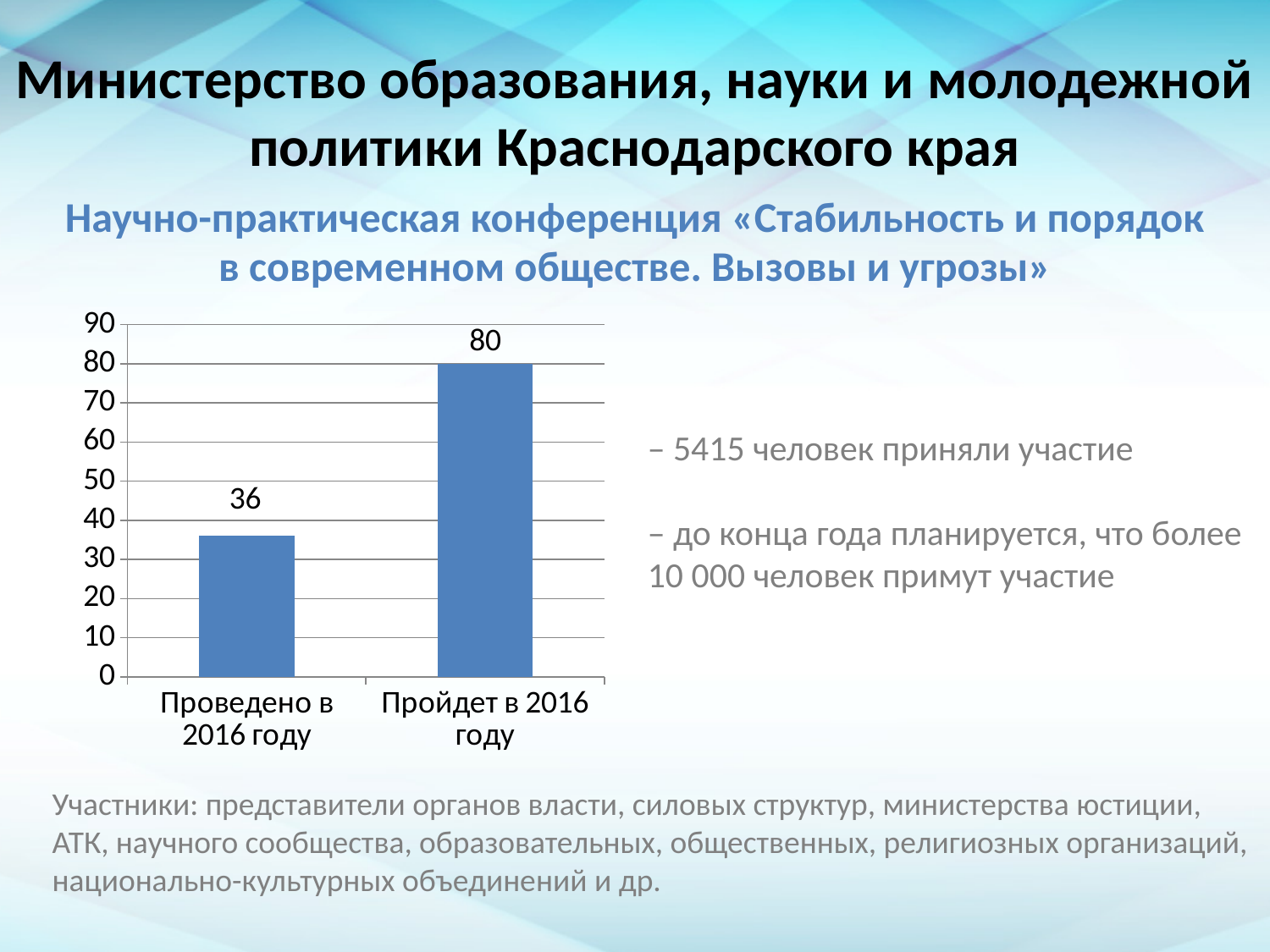
What is the difference between the values for "Пройдет в 2016 году" and "Проведено в 2016 году"? 44 How many categories are shown in the chart? 2 What is the total of the two bars in the chart? 116 Is the value for "Пройдет в 2016 году" greater or less than 70? greater Is the value for "Проведено в 2016 году" greater or less than 40? less What kind of chart is shown on the slide? bar chart Which category has the lowest value? Проведено в 2016 году What is the maximum value shown on the vertical axis? 90 What is the value for "Пройдет в 2016 году"? 80 Which category has the highest value? Пройдет в 2016 году Which is larger: the value for "Проведено в 2016 году" or the value for "Пройдет в 2016 году"? Пройдет в 2016 году What is the value for "Проведено в 2016 году"? 36